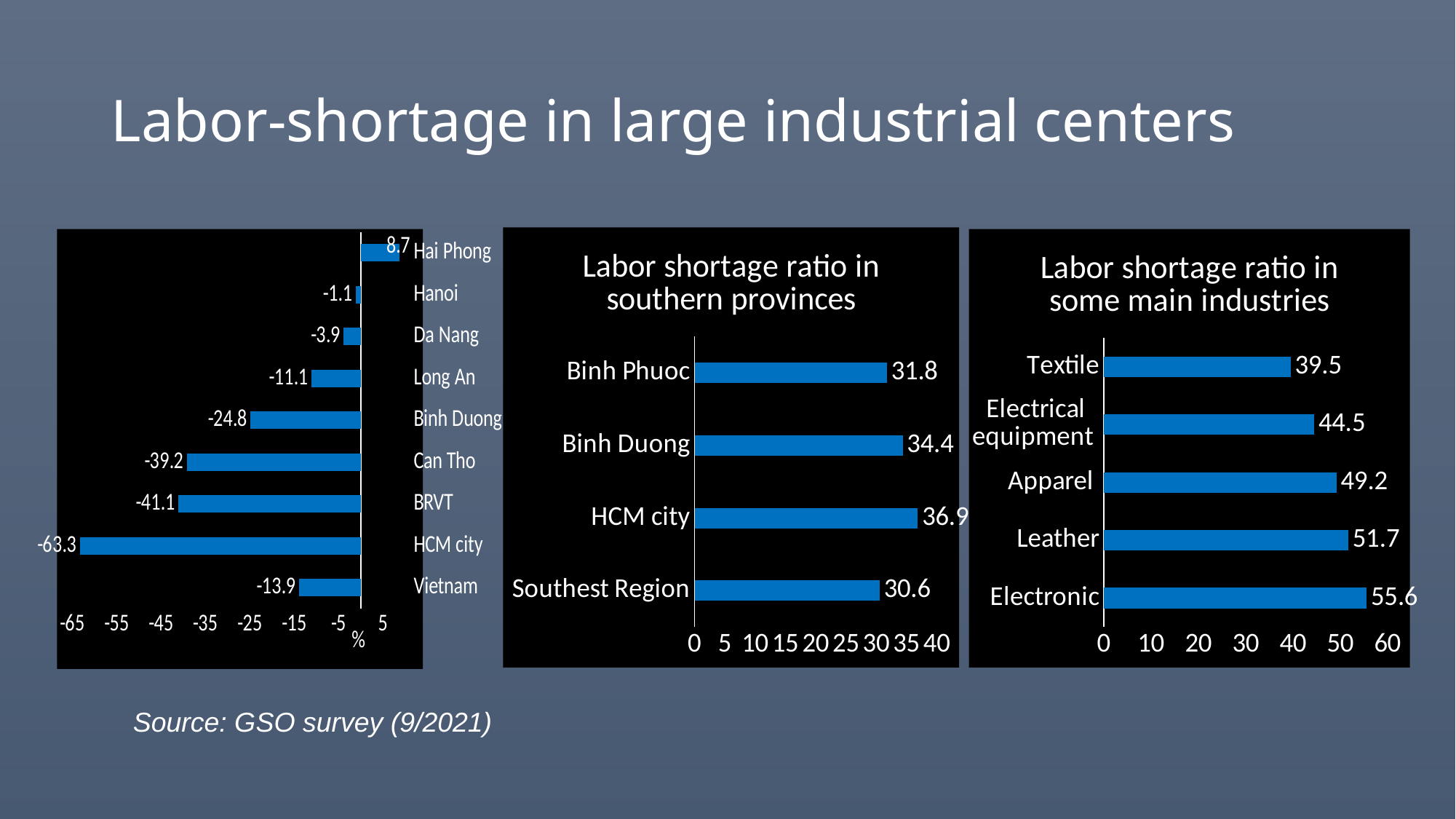
In the left chart (with categories Hai Phong to Vietnam), what is the value for HCM city? -63.3 In the 'Labor shortage ratio in some main industries' chart, how many categories are shown? 5 What kind of chart is the 'Labor shortage ratio in some main industries' chart? Bar chart In the 'Labor shortage ratio in some main industries' chart, which category has the lowest value? Textile In the 'Labor shortage ratio in southern provinces' chart, what is the value for Binh Duong? 34.4 In the 'Labor shortage ratio in some main industries' chart, which is larger, Apparel or Electrical equipment? Apparel In the 'Labor shortage ratio in some main industries' chart, what is the value for Leather? 51.7 In the 'Labor shortage ratio in southern provinces' chart, what is the difference between HCM city and Southest Region? 6.3 In the left chart (with categories Hai Phong to Vietnam), which category has the highest value? Hai Phong In the 'Labor shortage ratio in southern provinces' chart, which category has the highest value? HCM city In the left chart (with categories Hai Phong to Vietnam), what is the value for Vietnam? -13.9 In the left chart (with categories Hai Phong to Vietnam), how many categories are shown? 9